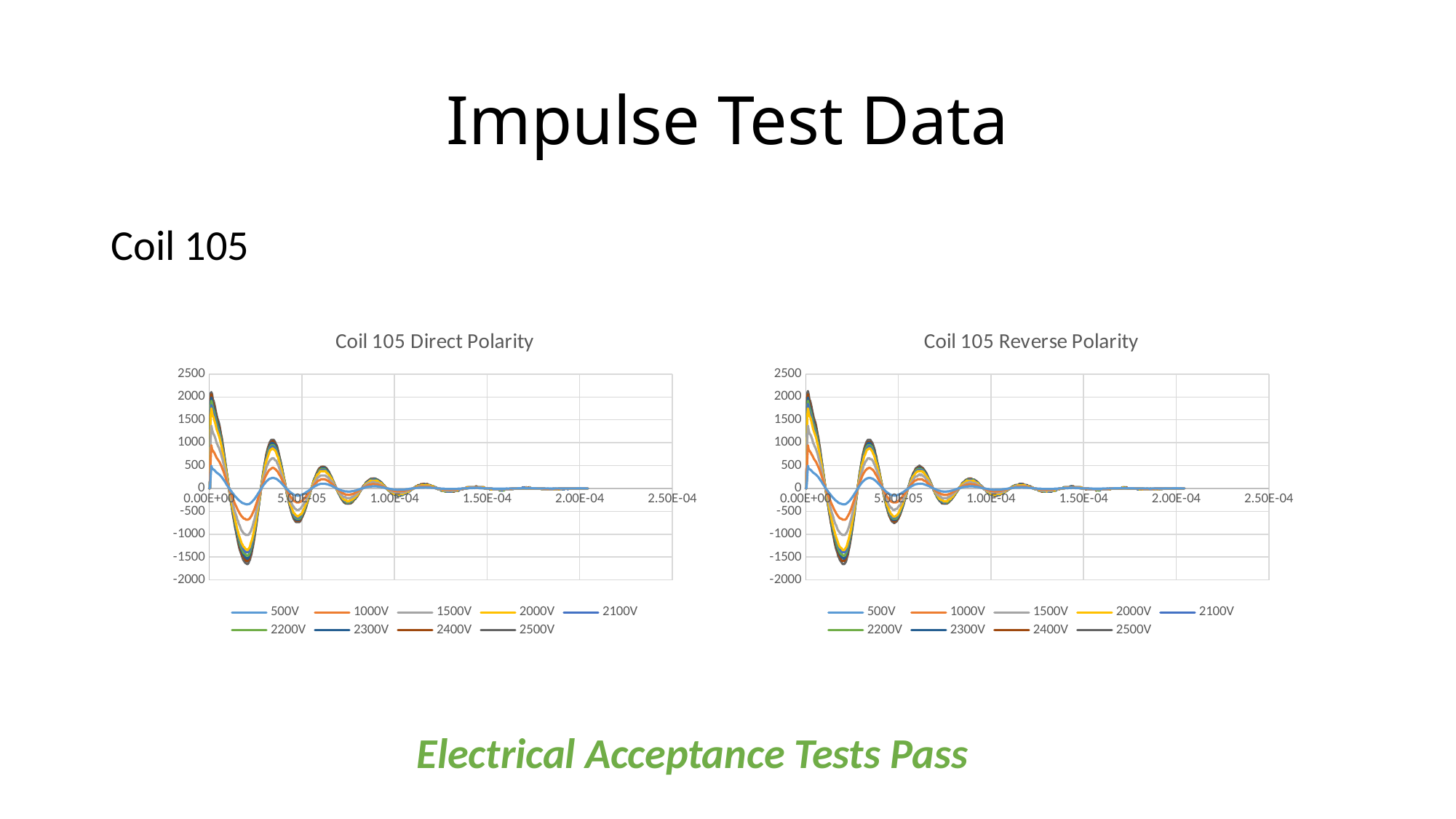
In the "Coil 105 Reverse Polarity" chart, is the initial peak of the 1000V series greater or less than 1500? less In the "Coil 105 Direct Polarity" chart, which series has the smallest initial peak? 500V In the "Coil 105 Direct Polarity" chart, is the initial peak of the 2500V series greater or less than 1500? greater In the "Coil 105 Direct Polarity" chart, is the initial peak of the 2500V series larger than that of the 1000V series? Yes What is the title of the chart on the right of the slide? Coil 105 Reverse Polarity How many series does the legend of the "Coil 105 Direct Polarity" chart list? 9 How many series does the legend of the "Coil 105 Reverse Polarity" chart list? 9 What kind of chart is the "Coil 105 Reverse Polarity" chart? line chart What kind of chart is the "Coil 105 Direct Polarity" chart? line chart In the "Coil 105 Reverse Polarity" chart, which series has the smallest initial peak? 500V What is the title of the chart on the left of the slide? Coil 105 Direct Polarity In the "Coil 105 Reverse Polarity" chart, does the amplitude of the oscillations increase or decrease along the x axis? decrease